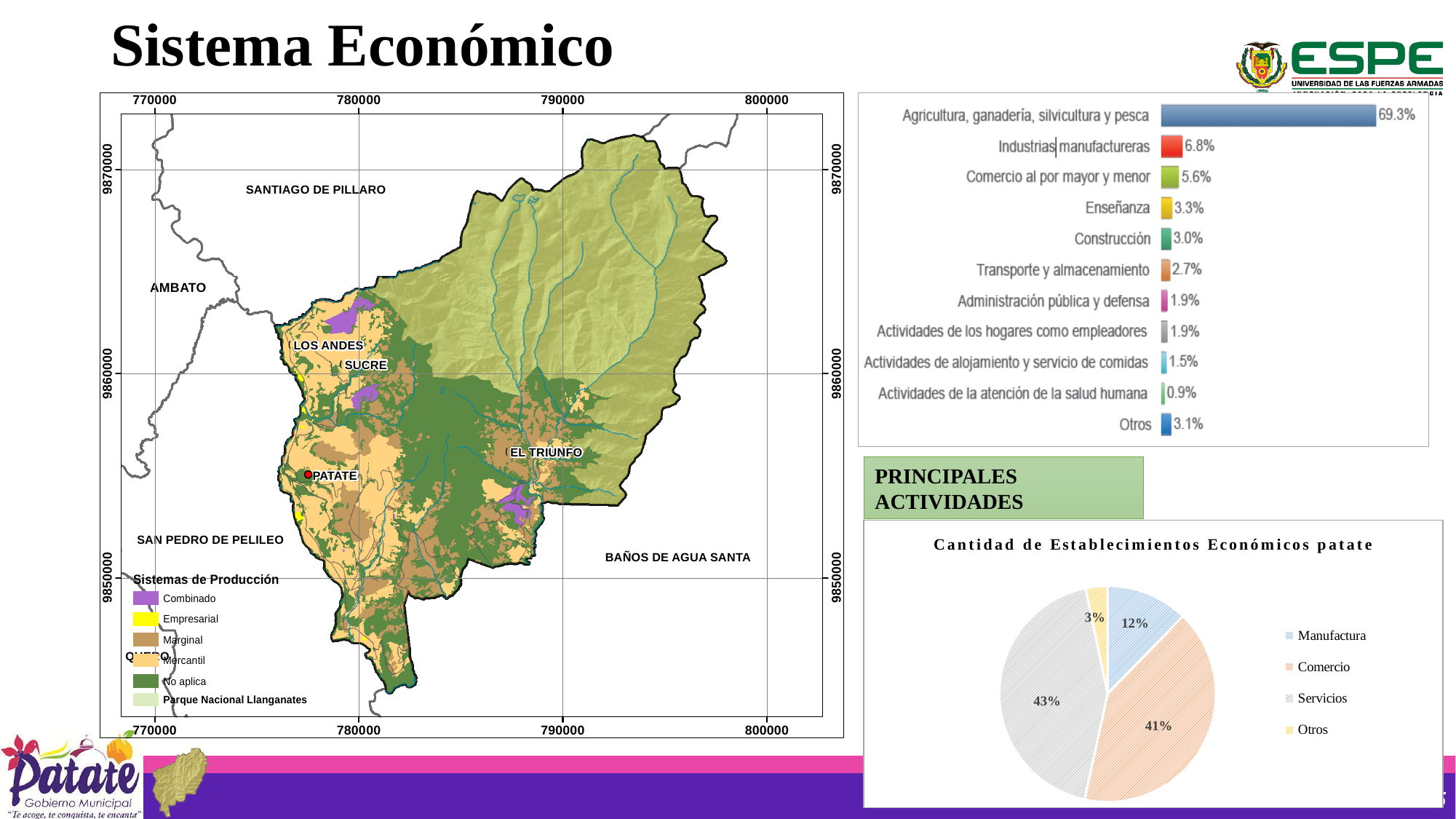
In the pie chart 'Cantidad de Establecimientos Económicos patate', what share does Servicios have? 43% What kind of chart is the chart at the top right of the slide? Bar chart In the bar chart at the top right of the slide, what is the value for Agricultura, ganadería, silvicultura y pesca? 69.3% In the bar chart at the top right of the slide, what is the difference between Industrias manufactureras and Comercio al por mayor y menor? 1.2% In the pie chart 'Cantidad de Establecimientos Económicos patate', which category has the smallest slice? Otros In the bar chart at the top right of the slide, what is the value for Enseñanza? 3.3% In the pie chart 'Cantidad de Establecimientos Económicos patate', what is the value for Manufactura? 12% In the bar chart at the top right of the slide, which category has the lowest value? Actividades de la atención de la salud humana In the bar chart at the top right of the slide, how many categories are shown? 11 In the bar chart at the top right of the slide, which is larger: Construcción or Transporte y almacenamiento? Construcción In the pie chart 'Cantidad de Establecimientos Económicos patate', how many categories does the legend list? 4 In the bar chart at the top right of the slide, what is the value for Industrias manufactureras? 6.8%